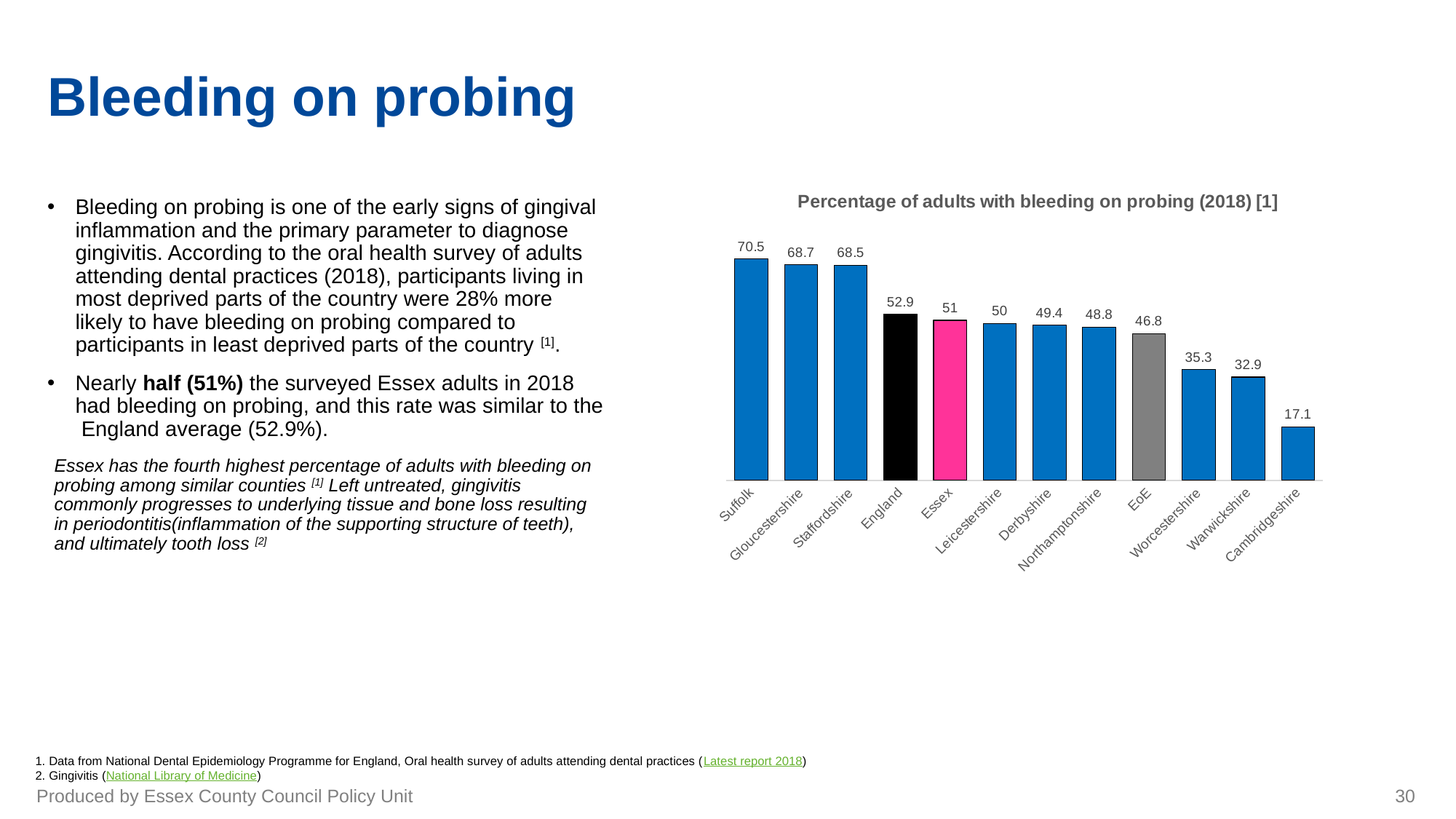
What is the value for England in the chart? 52.9 What kind of chart is shown on the slide? Bar chart How many categories are shown on the x axis? 12 What is the value for Cambridgeshire? 17.1 Do the values rise or fall from left to right along the x axis? Fall What is the difference between the values for England and Essex? 1.9 What is the difference between the values for Suffolk and Cambridgeshire? 53.4 What is the title of the chart? Percentage of adults with bleeding on probing (2018) [1] What is the value for Essex in the chart? 51 Which is larger, the value for Worcestershire or the value for Warwickshire? Worcestershire Which category has the lowest value? Cambridgeshire Which category has the highest value? Suffolk